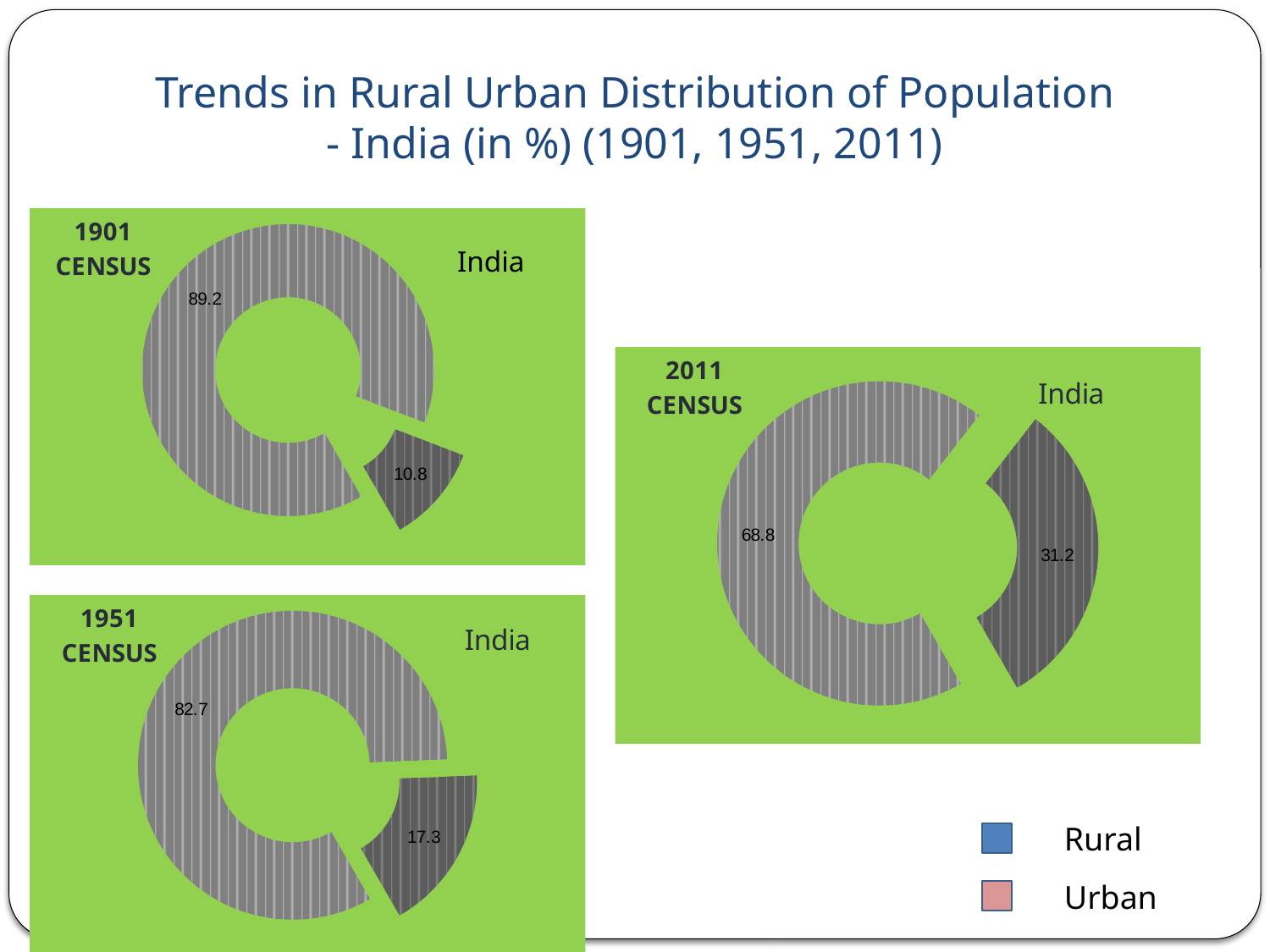
In the 2011 Census chart, what is the value for Rural? 68.8 In the 2011 Census chart, what is the value for Urban? 31.2 How many series does the legend list? 2 What kind of chart is used for the 1901 Census data? Doughnut chart In the 1901 Census chart, what is the value for Rural? 89.2 In the 2011 Census chart, what is the difference between the Rural and Urban values? 37.6 In the 1951 Census chart, what is the value for Rural? 82.7 In the 1951 Census chart, what is the difference between the Rural and Urban values? 65.4 Across the 1901, 1951 and 2011 Census charts, does the Urban value rise or fall over time? Rise In the 1951 Census chart, what is the value for Urban? 17.3 In the 1901 Census chart, what is the value for Urban? 10.8 In the 2011 Census chart, which slice is larger, Rural or Urban? Rural